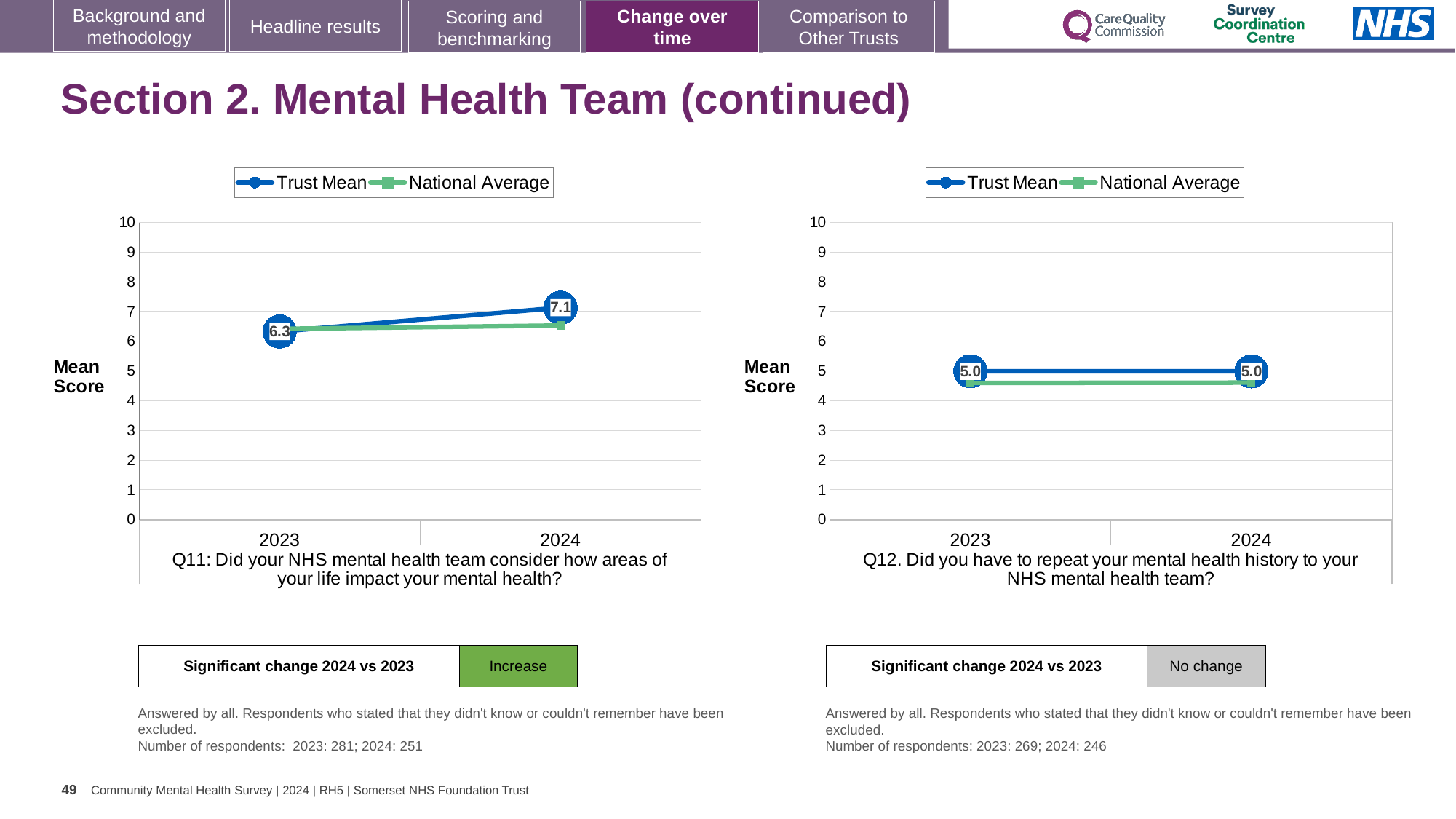
In the Q11 chart, what is the Trust Mean score for 2023? 6.3 In the Q11 chart, by how much did the Trust Mean change from 2023 to 2024? 0.8 In the Q12 chart, does the Trust Mean rise, fall or stay the same from 2023 to 2024? stay the same In the Q11 chart, does the Trust Mean rise or fall from 2023 to 2024? rise In the Q11 chart, is the National Average for 2024 greater or less than 7? less What kind of chart is the Q12 chart? line chart In the Q12 chart, is the National Average for 2024 greater or less than 5? less In the Q12 chart, what is the Trust Mean score for 2023? 5.0 In the Q11 chart, is the Trust Mean for 2024 larger or smaller than for 2023? larger In the Q11 chart, what is the Trust Mean score for 2024? 7.1 How many series does the legend of the Q11 chart list? 2 What does the 'Significant change 2024 vs 2023' box below the Q11 chart say? Increase